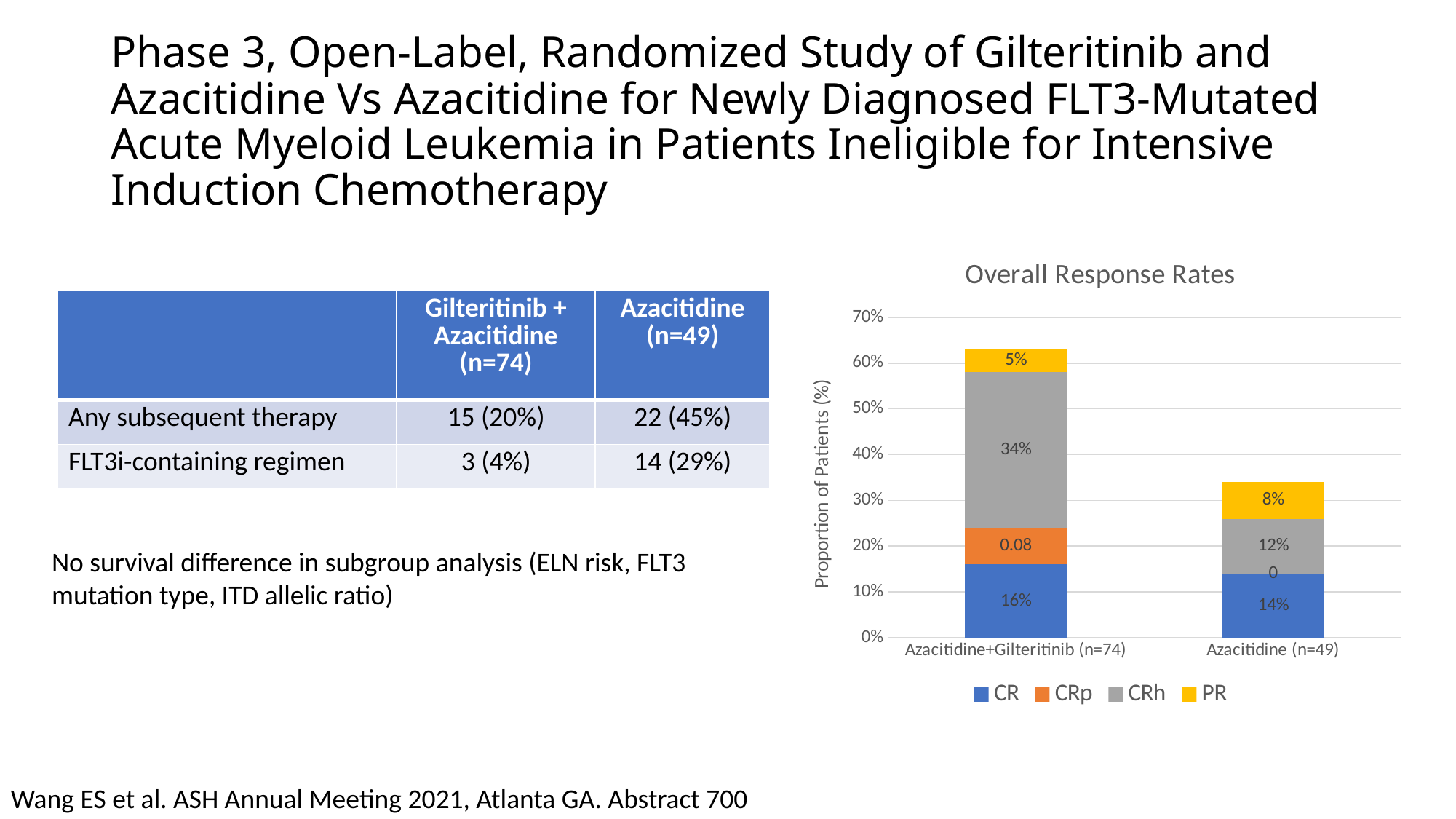
How many series does the legend of the Overall Response Rates chart list? 4 How many treatment groups (bars) are shown in the Overall Response Rates chart? 2 In the Overall Response Rates chart, what is the CR value for Azacitidine (n=49)? 14% In the Overall Response Rates chart, what is the CR value for Azacitidine+Gilteritinib (n=74)? 16% In the Overall Response Rates chart, what is the difference in CRh between Azacitidine+Gilteritinib (n=74) and Azacitidine (n=49)? 22 percentage points In the Overall Response Rates chart, what is the total height of the stacked bar for Azacitidine (n=49)? 34% What kind of chart is shown under the title "Overall Response Rates"? Stacked bar chart In the Overall Response Rates chart, what is the CRh value for Azacitidine+Gilteritinib (n=74)? 34% In the Overall Response Rates chart, what is the PR value for Azacitidine (n=49)? 8% In the Overall Response Rates chart, which group has the higher PR value? Azacitidine (n=49) In the Overall Response Rates chart, is the total height of the Azacitidine+Gilteritinib (n=74) bar greater or less than 60%? greater In the Overall Response Rates chart, what is the CRh value for Azacitidine (n=49)? 12%